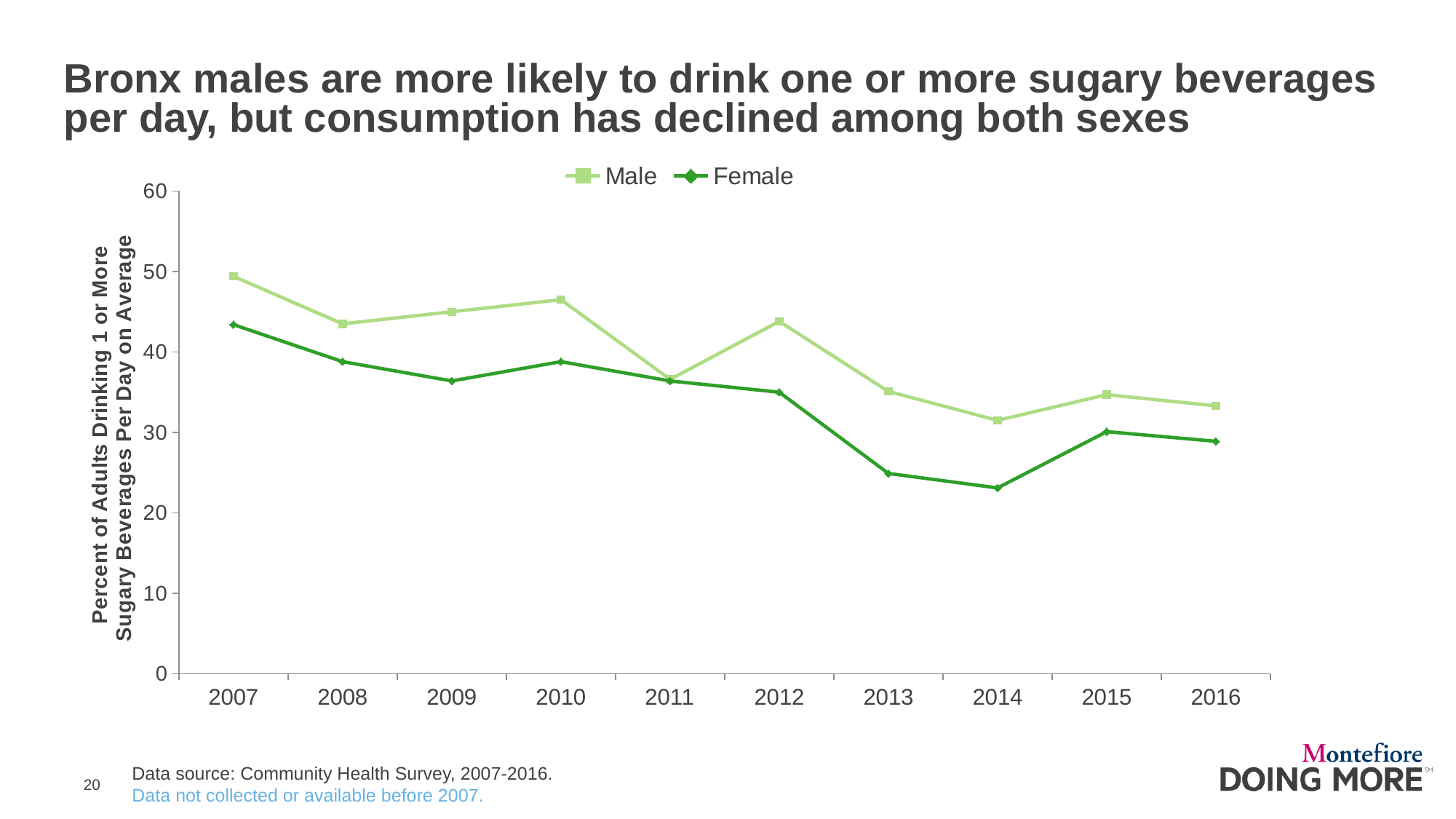
How many years are plotted along the x axis? 10 In which year is the Male value lowest? 2014 What kind of chart is shown on the slide? Line chart Is the Male value for 2007 greater or less than 40? greater Do the Female values generally rise or fall from 2007 to 2016? Fall What is the label on the vertical axis? Percent of Adults Drinking 1 or More Sugary Beverages Per Day on Average Is the Female value for 2014 greater or less than 30? less In which year is the Female value lowest? 2014 In which year is the Male value highest? 2007 How many series does the legend list? 2 Is the Female value for 2009 greater or less than 40? less Which series has the larger value in 2013, Male or Female? Male